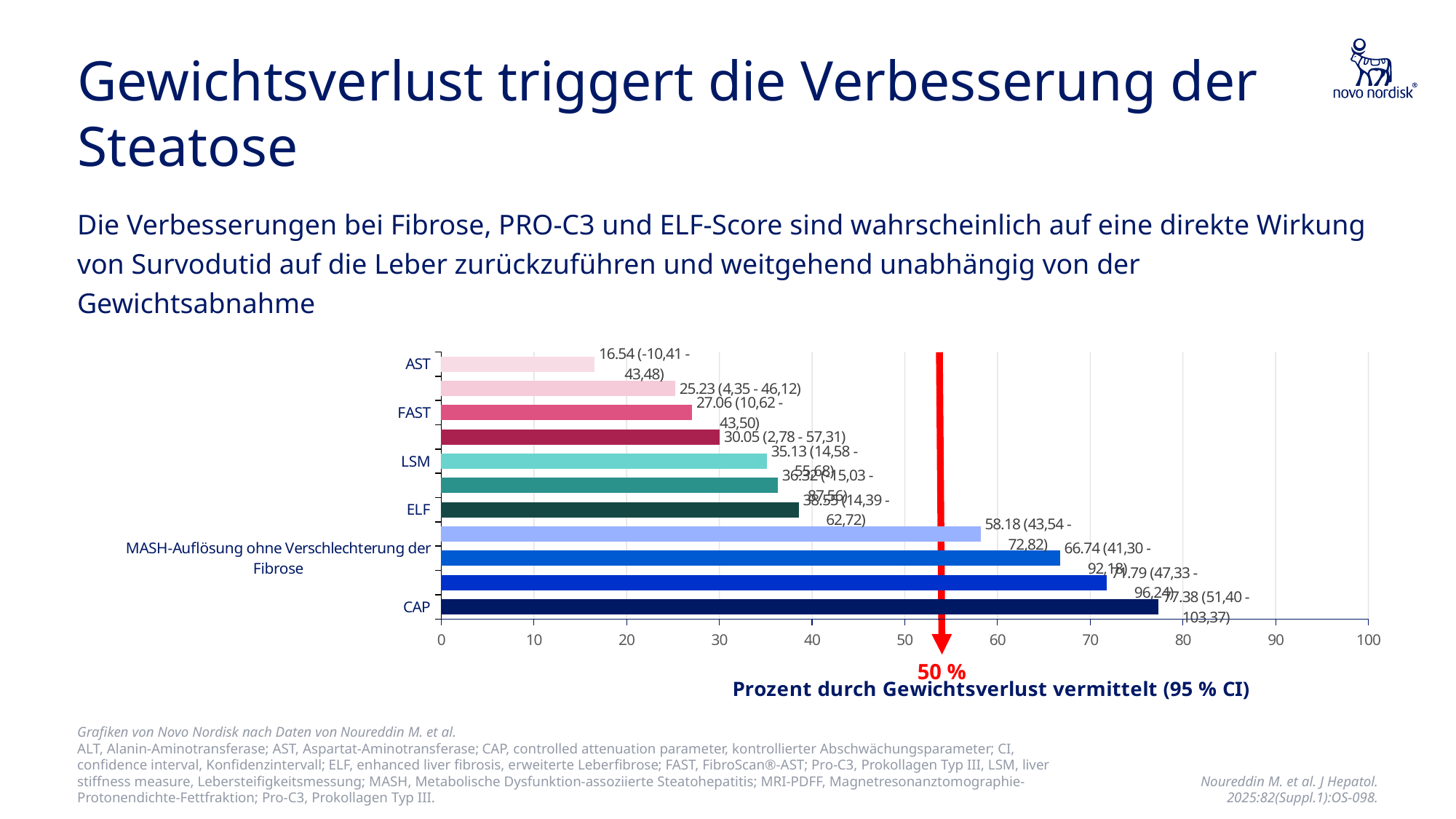
What is the value for LSM? 35.13 What kind of chart is shown on the slide? bar chart What is the value for FAST? 27.06 What is the value for CAP? 77.38 What is the value for AST? 16.54 What value does the red vertical line on the chart mark? 50 % What is the difference between the values for CAP and AST? 60.84 Which labelled category has the lowest value? AST Is the value for CAP greater or less than 50? greater What is the value for ELF? 38.55 Which is larger, the value for ELF or the value for FAST? ELF Which labelled category has the highest value? CAP